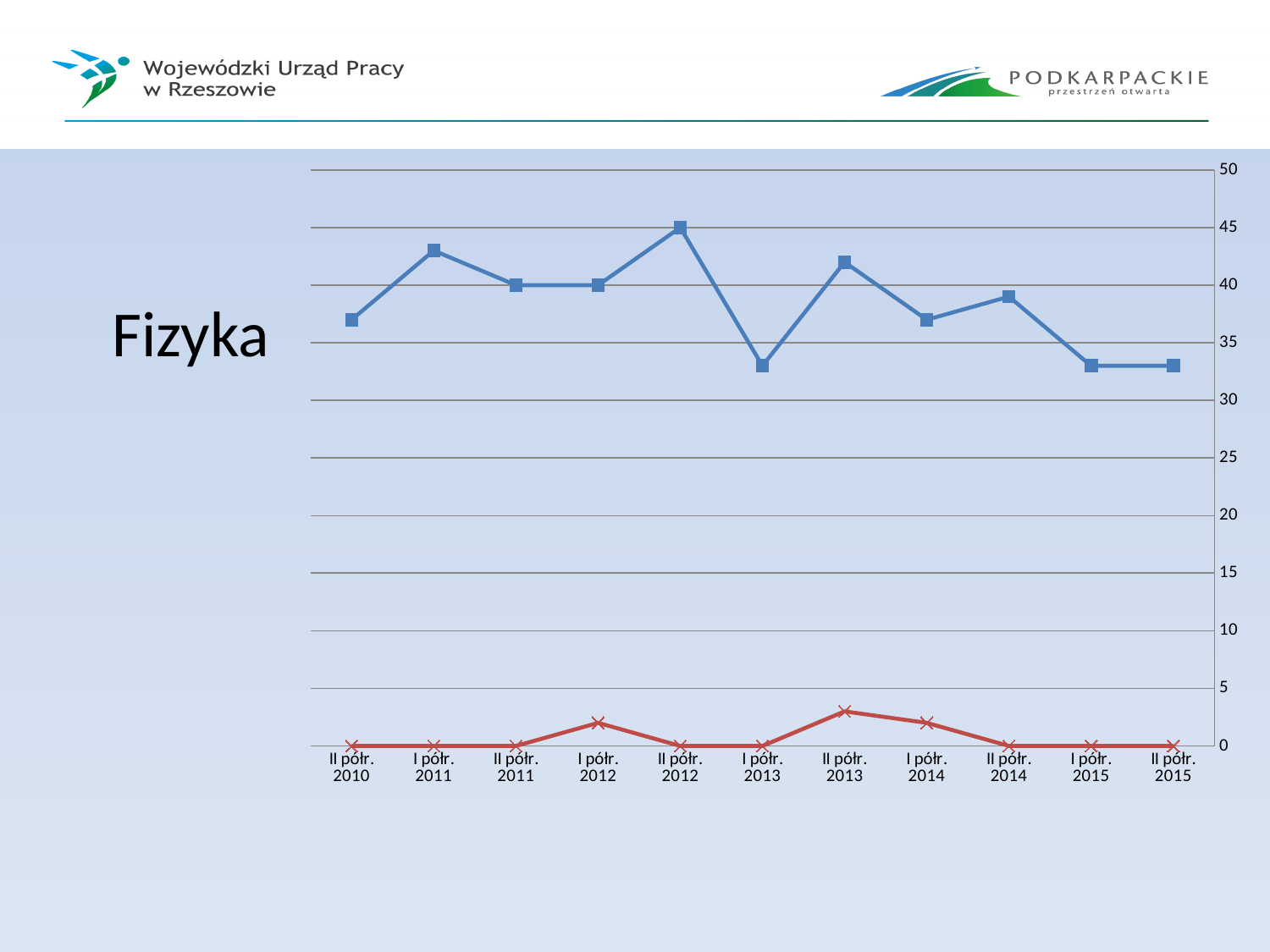
How many lines are plotted on the chart? 2 What is the value of the upper (blue) line for II półr. 2012? 45 On the upper (blue) line, which is larger: the value for II półr. 2012 or the value for I półr. 2013? II półr. 2012 What kind of chart is shown on the slide? line chart Is the value of the upper (blue) line for I półr. 2013 greater or less than 35? less What is the value of the lower (red) line for II półr. 2010? 0 What is the value of the upper (blue) line for II półr. 2011? 40 What subject name is written as the title next to the chart? Fizyka Does the upper (blue) line rise or fall between II półr. 2012 and I półr. 2013? fall Is the value of the upper (blue) line for I półr. 2011 greater or less than 40? greater In which period does the upper (blue) line reach its highest value? II półr. 2012 How many periods are shown along the x axis of the chart? 11